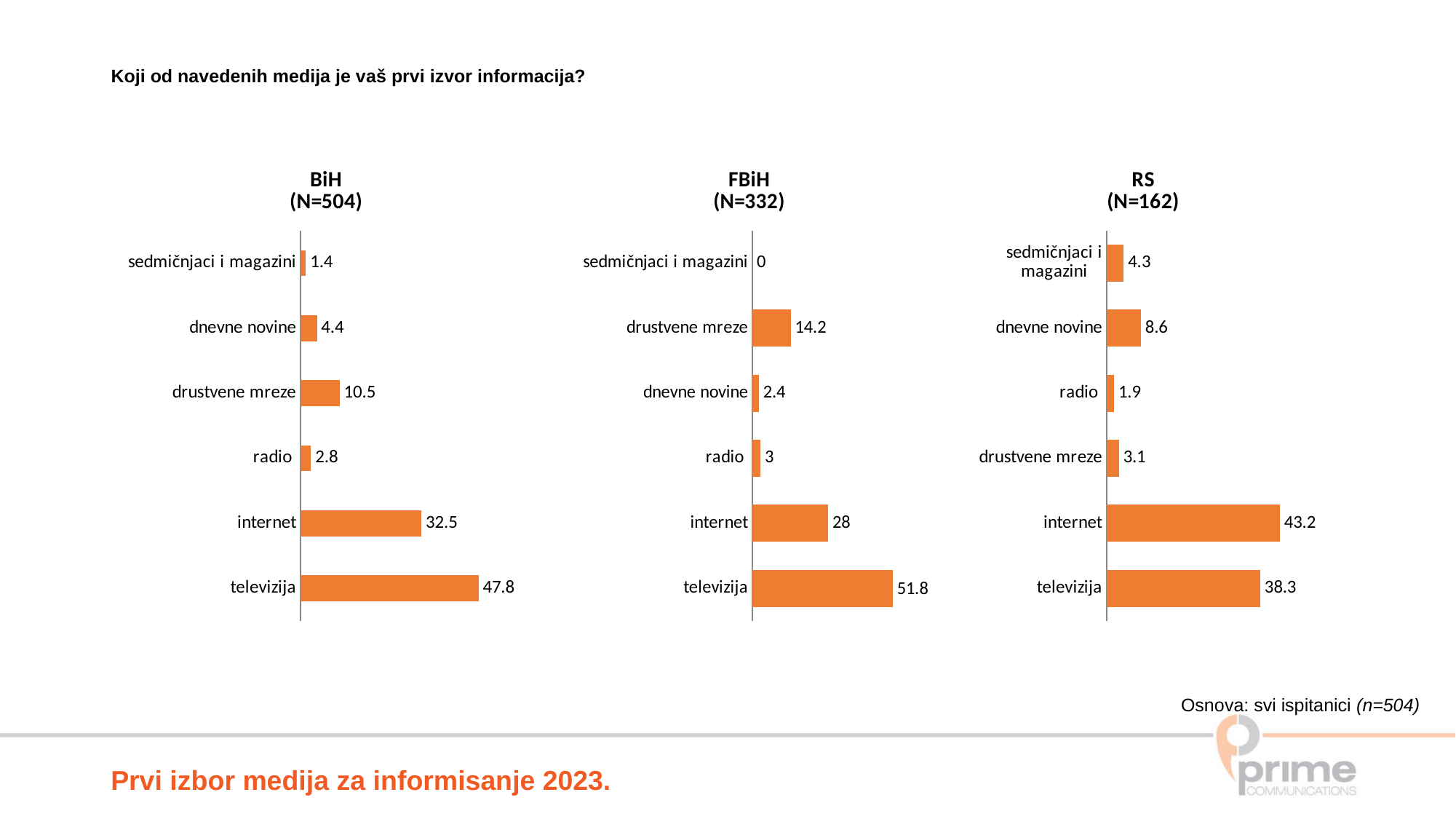
How many charts are shown on the slide? 3 In the BiH (N=504) chart, which category has the lowest value? sedmičnjaci i magazini In the FBiH (N=332) chart, what is the value for drustvene mreze? 14.2 In the BiH (N=504) chart, what is the difference between televizija and internet? 15.3 In the RS (N=162) chart, which is larger, internet or televizija? internet In the RS (N=162) chart, what is the value for dnevne novine? 8.6 In the BiH (N=504) chart, what is the value for televizija? 47.8 In the FBiH (N=332) chart, which category has the lowest value? sedmičnjaci i magazini What kind of chart is the FBiH (N=332) chart? bar chart How many categories does the BiH (N=504) chart show? 6 In the FBiH (N=332) chart, what is the difference between televizija and internet? 23.8 In the RS (N=162) chart, which category has the highest value? internet